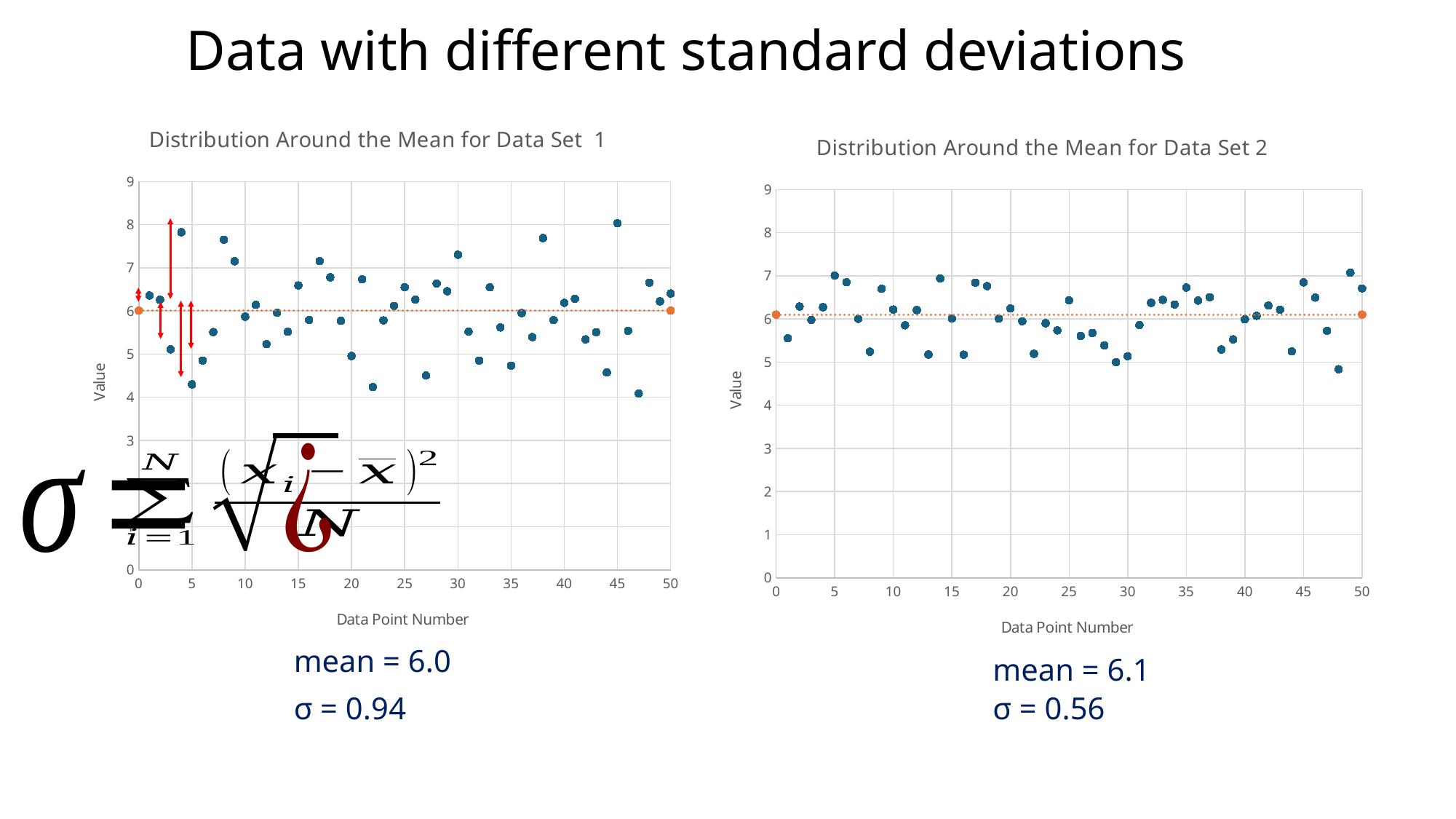
What kind of chart is "Distribution Around the Mean for Data Set 1"? scatter chart In the chart "Distribution Around the Mean for Data Set 2", is the value for data point 14 greater or less than 6? greater In the chart "Distribution Around the Mean for Data Set 1", is the value for data point 5 greater or less than 5? less Which data set has the larger stated standard deviation, Data Set 1 or Data Set 2? Data Set 1 In the chart "Distribution Around the Mean for Data Set 2", is the value for data point 8 greater or less than 6? less In the chart "Distribution Around the Mean for Data Set 1", what is the x-axis label? Data Point Number What standard deviation (σ) is stated below the chart "Distribution Around the Mean for Data Set 2"? 0.56 What mean is stated below the chart "Distribution Around the Mean for Data Set 1"? 6.0 What is the title of the chart on the right side of the slide? Distribution Around the Mean for Data Set 2